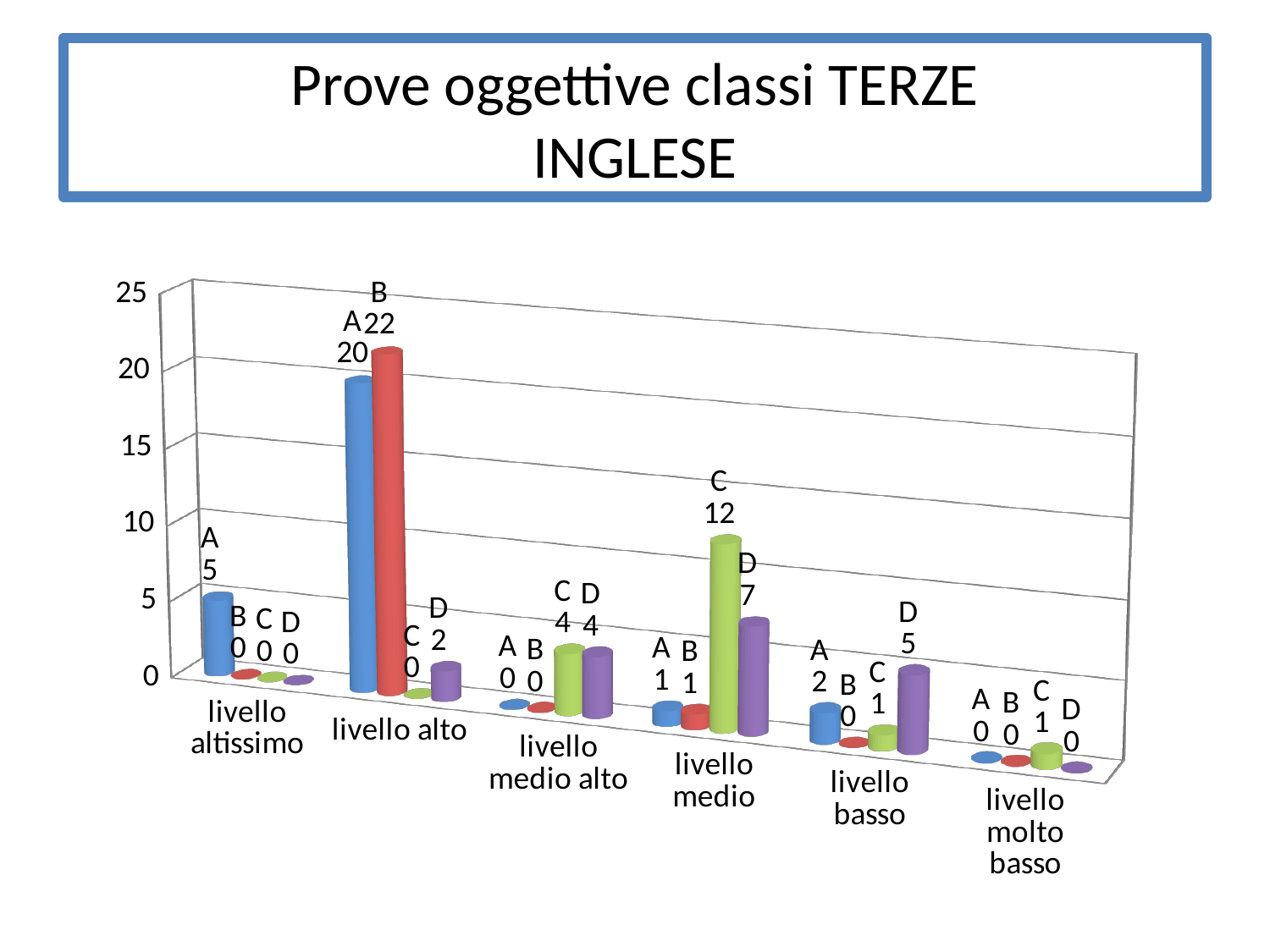
What is the value for series A in the 'livello altissimo' category? 5 What is the value for series B in the 'livello alto' category? 22 What is the difference between series B and series A in the 'livello alto' category? 2 How many categories are shown on the x axis? 6 What is the difference between series C and series D in the 'livello medio' category? 5 What is the title of the slide? Prove oggettive classi TERZE INGLESE Which series has the highest value in the 'livello alto' category? B Which series has the lowest value in the 'livello medio' category? A and B (both 1) What kind of chart is shown on the slide? bar chart In the 'livello basso' category, which is larger: series A or series D? D What is the value for series C in the 'livello medio' category? 12 What is the value for series D in the 'livello basso' category? 5